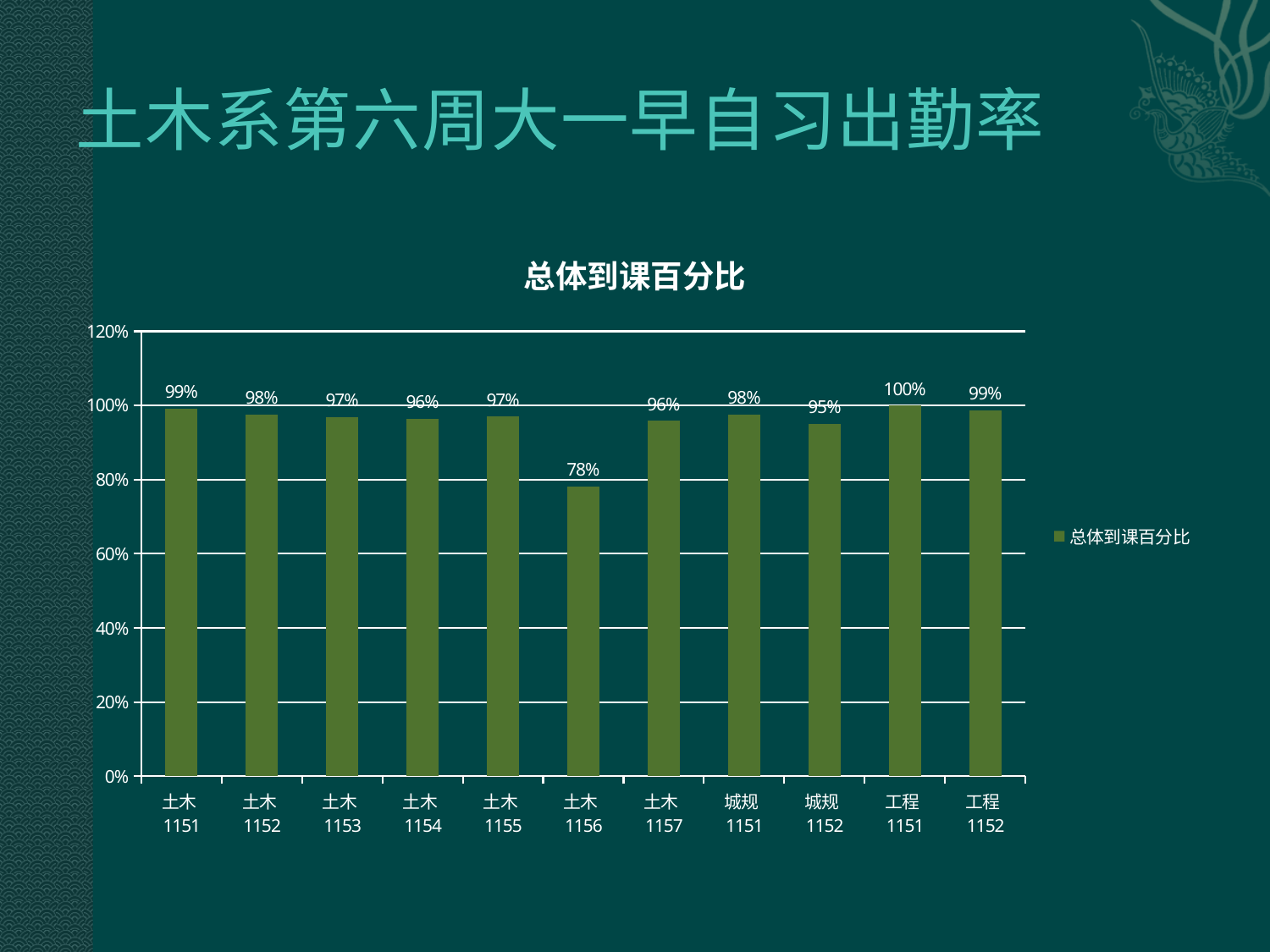
What is the value for 土木1156? 78% Which category has the lowest value? 土木1156 What kind of chart is shown? bar chart What is the value for 工程1151? 100% What is the value for 城规1152? 95% How many series does the legend list? 1 Which is larger, the value for 土木1151 or the value for 土木1156? 土木1151 Is the value for 土木1156 greater or less than 80%? less Which category has the highest value? 工程1151 How many categories are shown on the x axis? 11 What is the title of the chart? 总体到课百分比 What is the difference between the values for 工程1151 and 土木1156? 22%